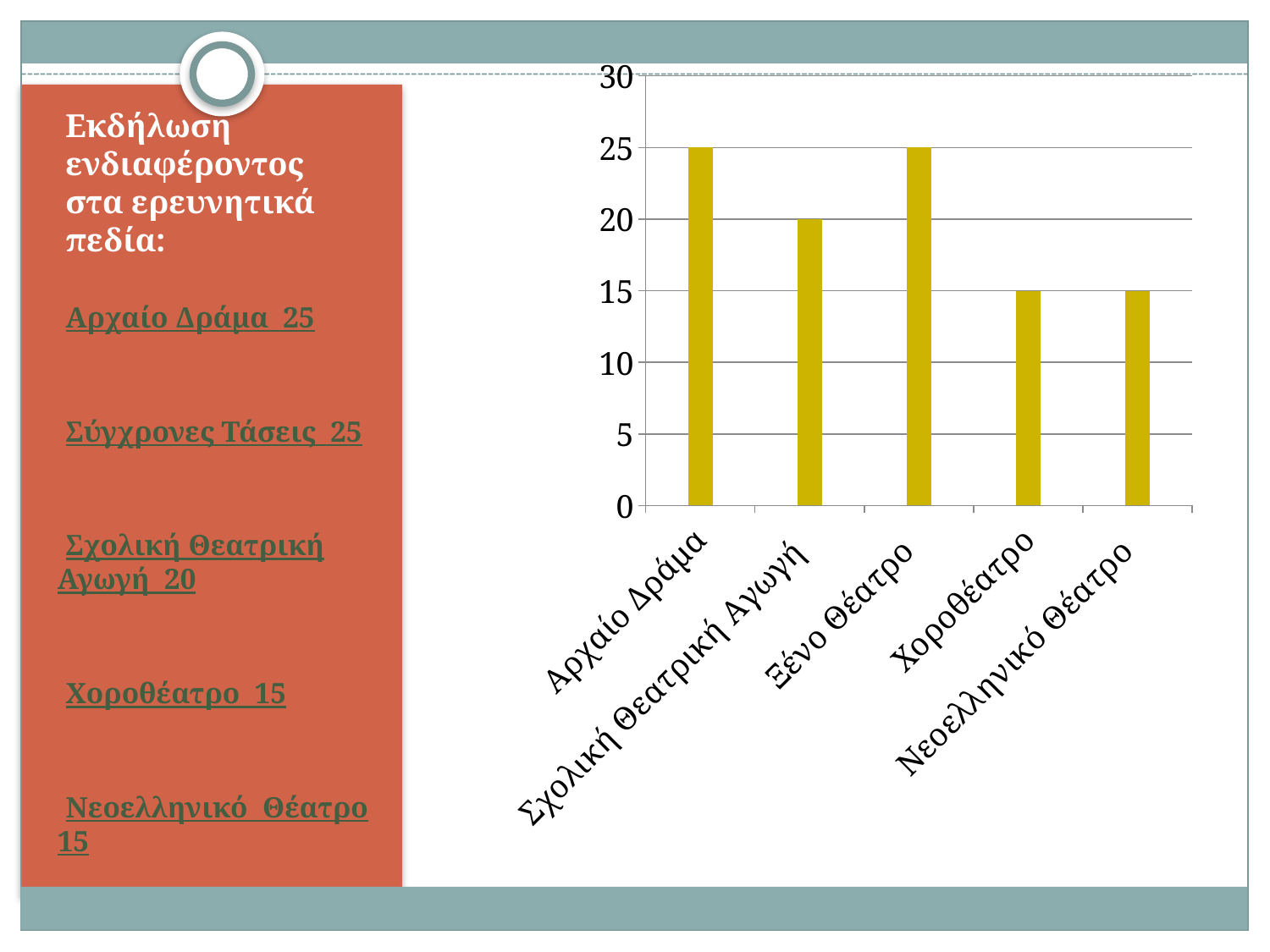
How many categories are plotted on the chart? 5 What is the highest value shown on the vertical axis of the chart? 30 What is the value for Αρχαίο Δράμα? 25 What is the value for Νεοελληνικό Θέατρο? 15 Is the value for Χοροθέατρο greater or less than 20? less What is the difference between the values for Αρχαίο Δράμα and Σχολική Θεατρική Αγωγή? 5 What is the value for Σχολική Θεατρική Αγωγή? 20 What is the value for Ξένο Θέατρο? 25 What is the difference between the values for Ξένο Θέατρο and Χοροθέατρο? 10 What is the value for Χοροθέατρο? 15 Which is larger, the value for Σχολική Θεατρική Αγωγή or the value for Νεοελληνικό Θέατρο? Σχολική Θεατρική Αγωγή What type of chart is shown on the slide? bar chart